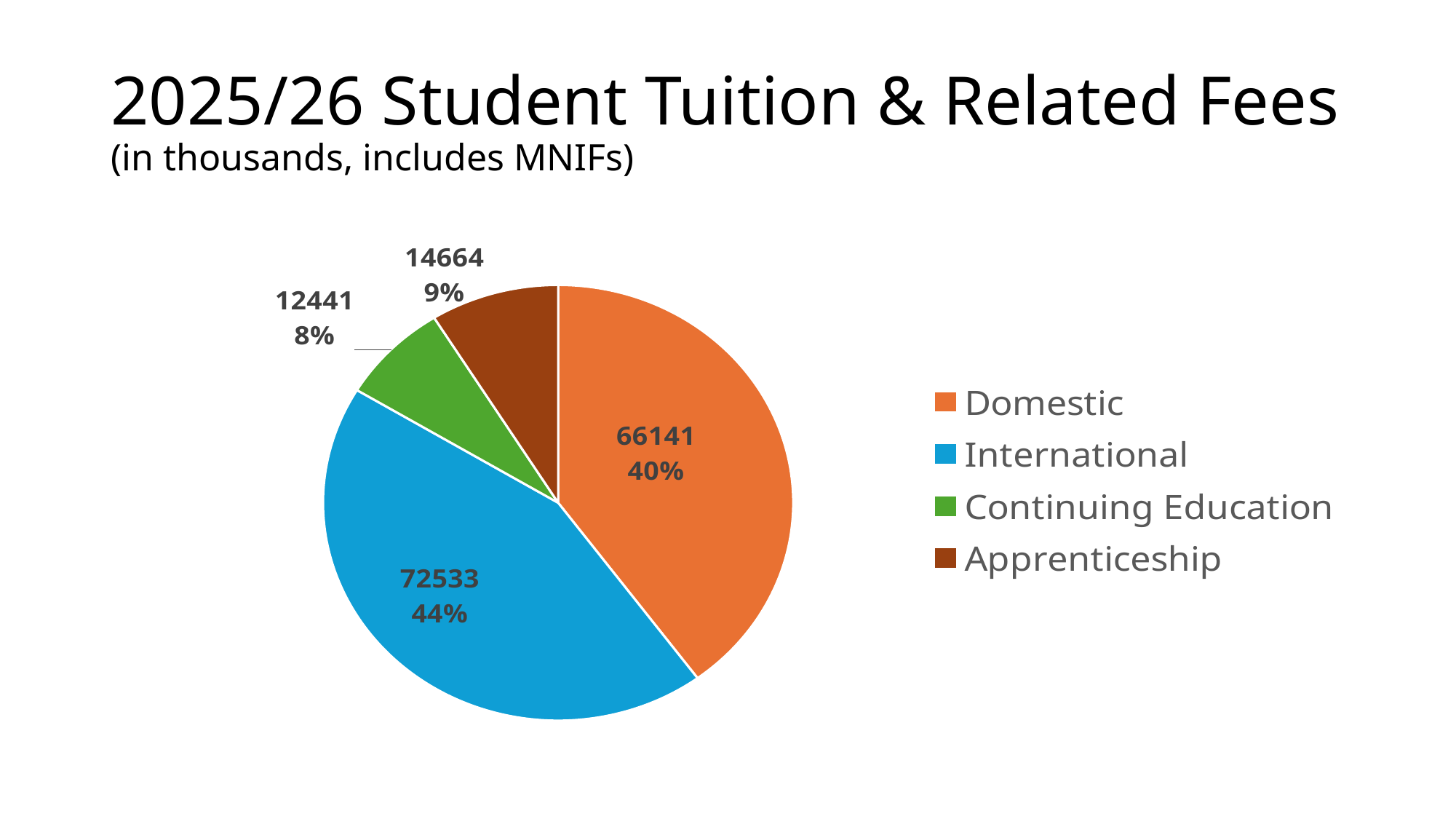
How many categories does the legend list? 4 What share of the pie does International represent? 44% What is the value for Domestic? 66141 What is the value for Apprenticeship? 14664 Which is larger, Apprenticeship or Continuing Education? Apprenticeship What is the value for Continuing Education? 12441 Which category has the smallest slice? Continuing Education What is the difference between the International and Domestic values? 6392 What is the value for International? 72533 What share of the pie does Apprenticeship represent? 9% What type of chart is shown on the slide? pie chart Which category has the largest slice? International